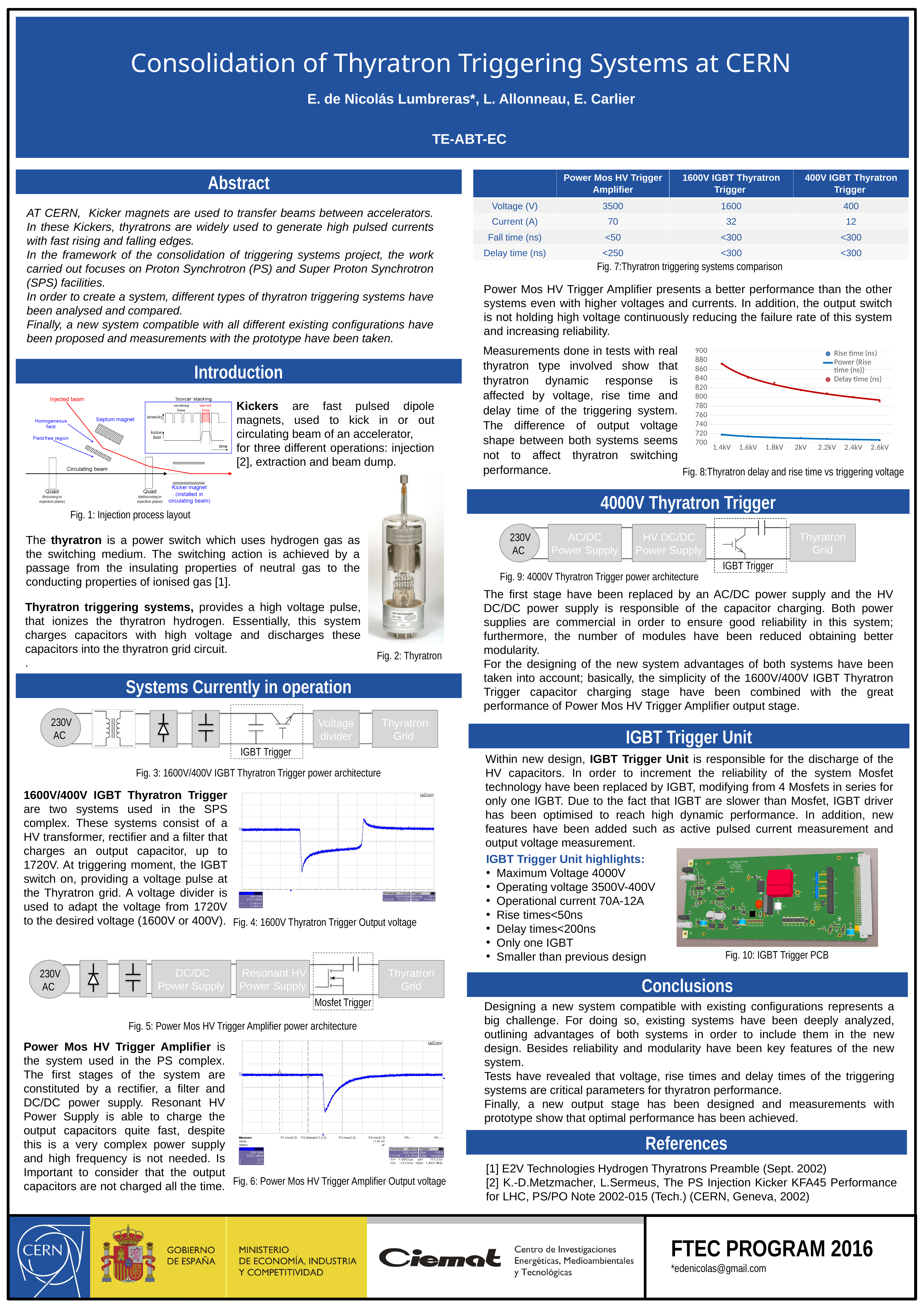
What is the caption of the chart showing delay and rise time versus triggering voltage? Fig. 8: Thyratron delay and rise time vs triggering voltage In Fig. 8, how does the delay time change as the triggering voltage increases from 1.4kV to 2.6kV? It falls In Fig. 8, is the delay time at 2.6kV greater or less than 820? less In Fig. 8, at which triggering voltage is the delay time lowest? 2.6kV In Fig. 8, is the delay time at 1.4kV greater or less than 840? greater What kind of chart is Fig. 8 (Thyratron delay and rise time vs triggering voltage)? Line chart In Fig. 8, how many entries does the legend list? 3 In Fig. 8, at which triggering voltage is the delay time highest? 1.4kV In Fig. 8, what colour is used for the Delay time (ns) series? Red In Fig. 8, which is larger at 2kV, the delay time or the rise time? Delay time In Fig. 8, how many voltage tick labels are shown on the x axis? 7 In Fig. 8, is the rise time at 1.4kV greater or less than 740? less